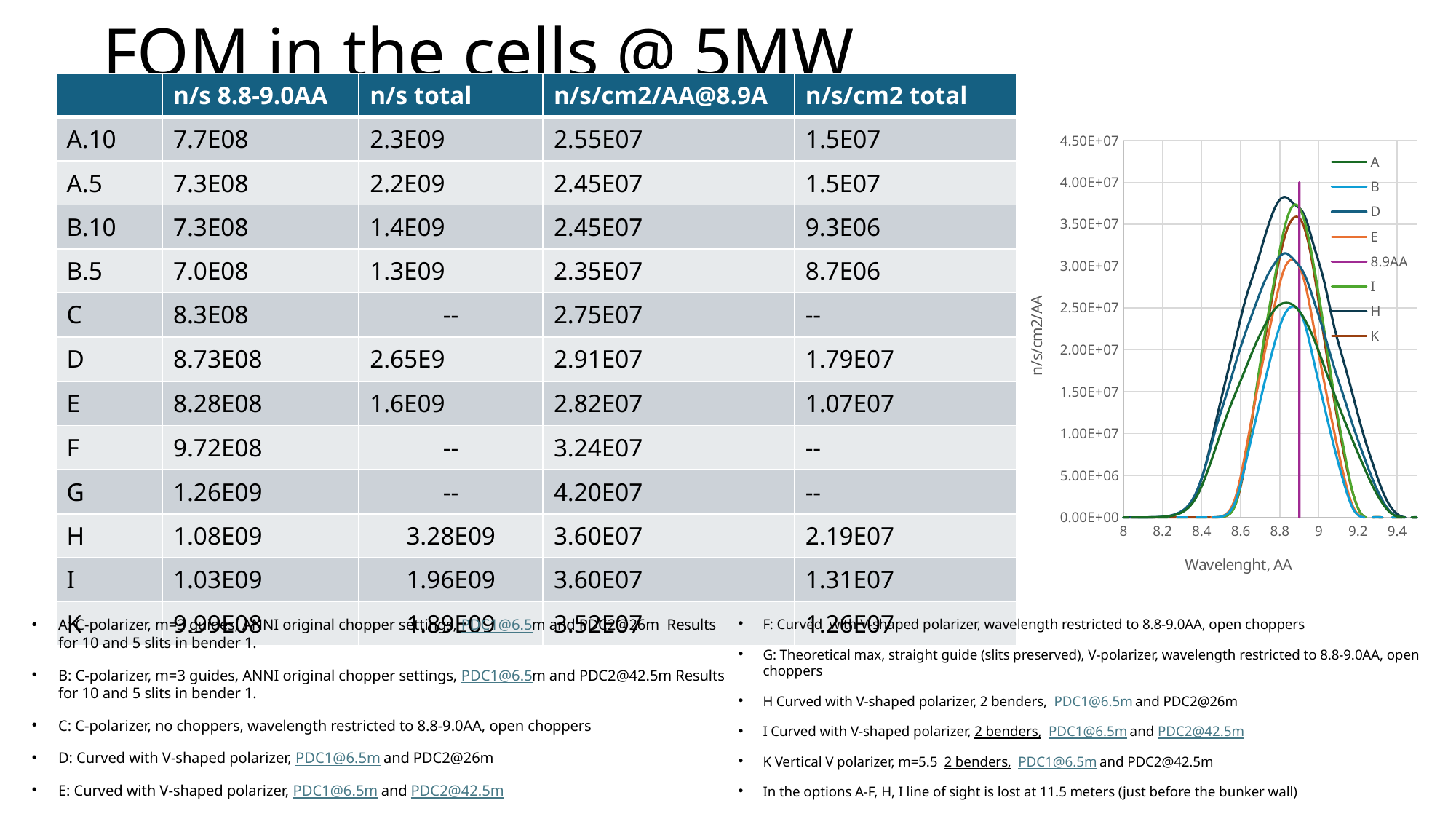
How many series does the legend of the chart list? 8 What is the title of the y axis of the chart? n/s/cm2/AA Is the peak value of series E greater or less than 3.50E+07? less What is the title of the x axis of the chart? Wavelenght, AA What kind of chart is shown on the right of the slide? line chart Do the values of series H rise or fall along the x axis between 8.4 and 8.8? rise Is the peak value of series K greater or less than 3.00E+07? greater Is the peak value of series H greater or less than 3.50E+07? greater Do the values of series I rise or fall along the x axis between 9.0 and 9.4? fall